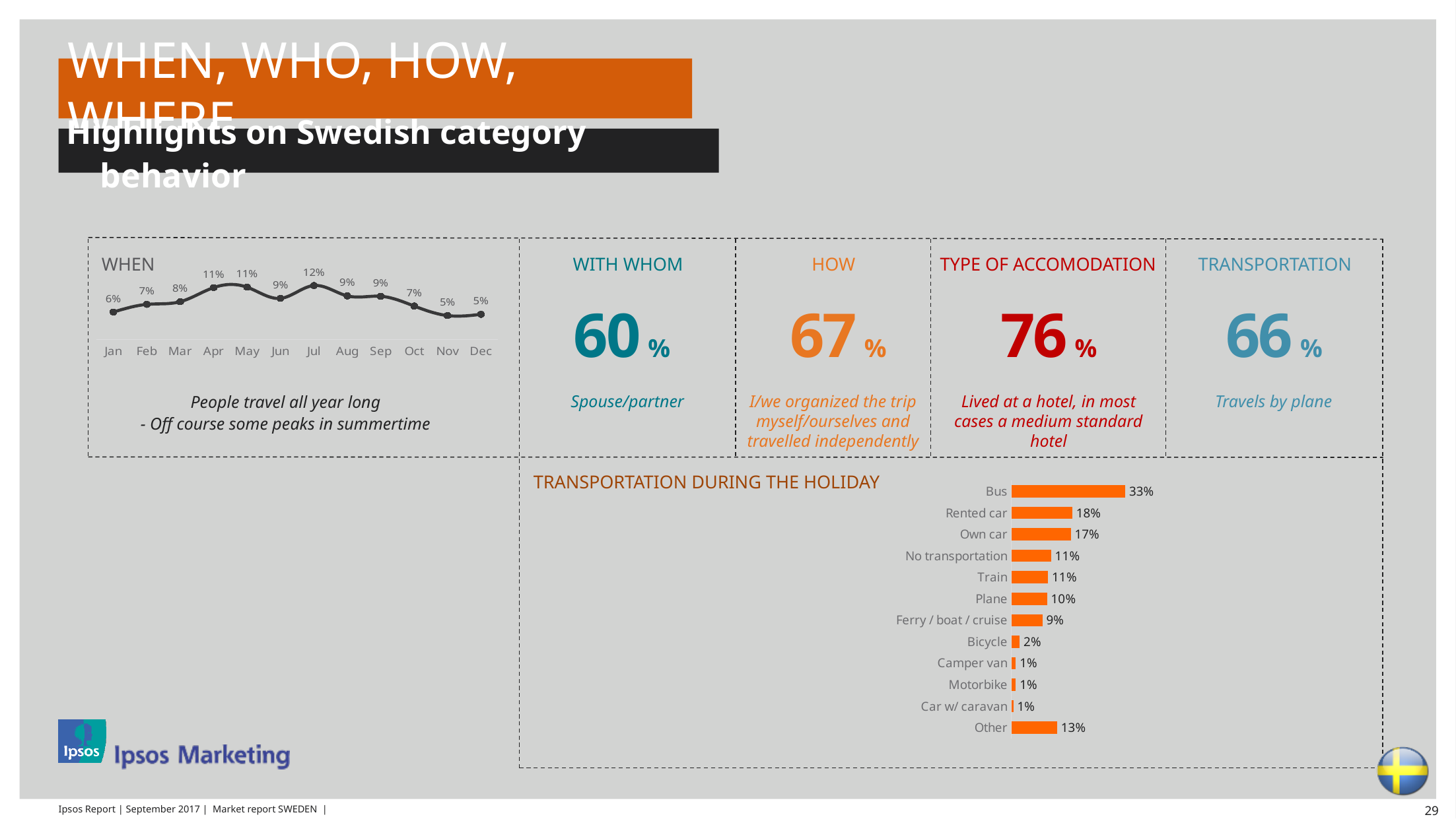
In the TRANSPORTATION DURING THE HOLIDAY chart, what is the value for Bus? 33% In the WHEN line chart, do the values rise or fall from September to November? fall How many categories are shown in the TRANSPORTATION DURING THE HOLIDAY chart? 12 What kind of chart is the TRANSPORTATION DURING THE HOLIDAY chart? bar chart In the TRANSPORTATION DURING THE HOLIDAY chart, what is the difference between Rented car and Own car? 1% In the WHEN line chart, what is the value for July? 12% How many months are plotted in the WHEN line chart? 12 In the WHEN line chart, what is the difference between the values for April and January? 5% In the TRANSPORTATION DURING THE HOLIDAY chart, what is the value for Ferry / boat / cruise? 9% In the TRANSPORTATION DURING THE HOLIDAY chart, which is larger, Other or Plane? Other In the TRANSPORTATION DURING THE HOLIDAY chart, which category has the highest value? Bus In the WHEN line chart, which month has the highest value? Jul